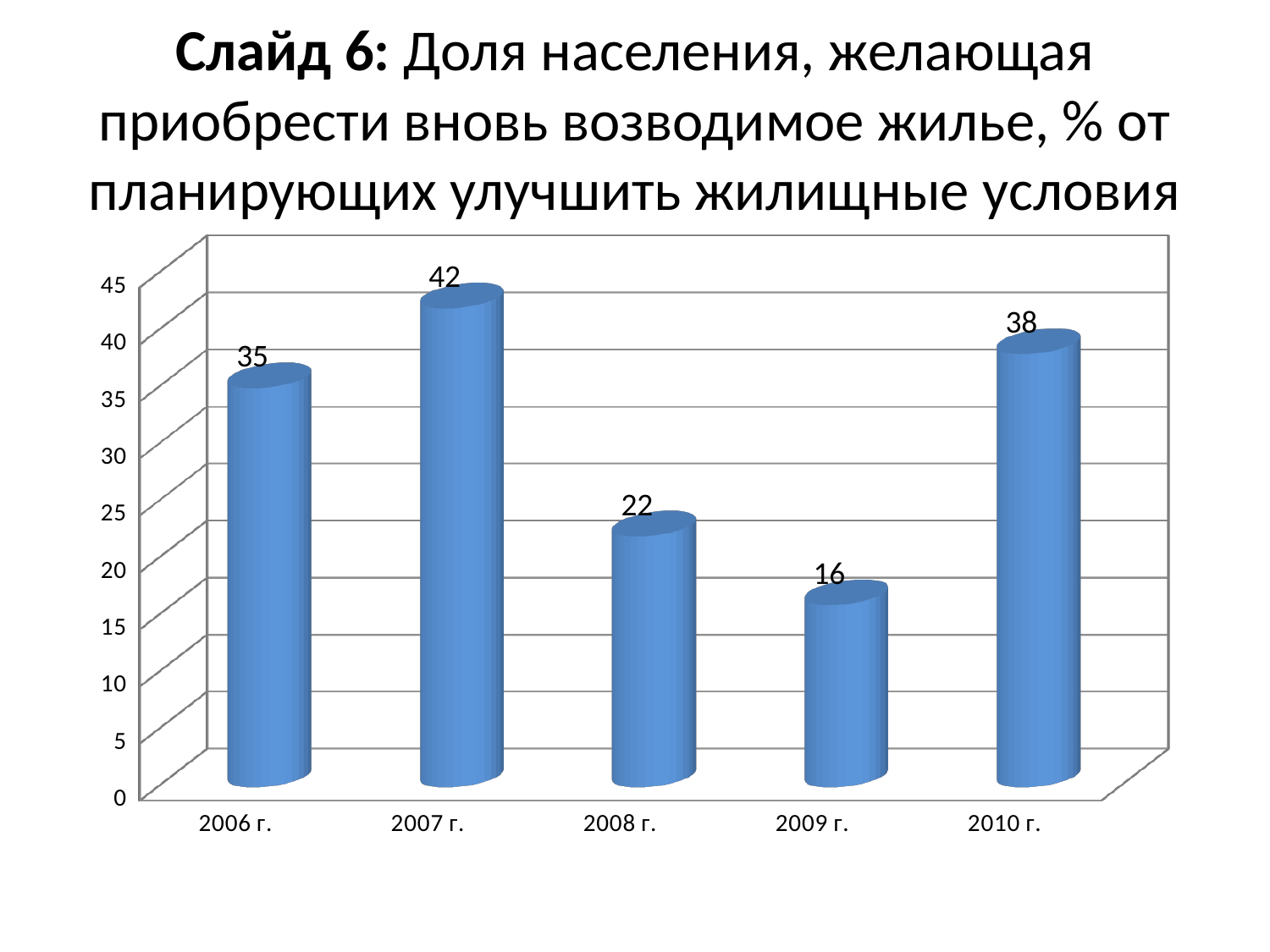
What is the value for 2010 г.? 38 What kind of chart is shown on the slide? bar chart What is the value for 2007 г.? 42 Do the values rise or fall from 2007 г. to 2009 г.? fall How many years are shown on the x axis? 5 What is the value for 2009 г.? 16 What is the difference between the values for 2010 г. and 2006 г.? 3 What is the difference between the values for 2007 г. and 2009 г.? 26 Which is larger, the value for 2006 г. or the value for 2008 г.? 2006 г. Is the value for 2008 г. greater or less than 25? less Which year has the lowest value? 2009 г. Which year has the highest value? 2007 г.